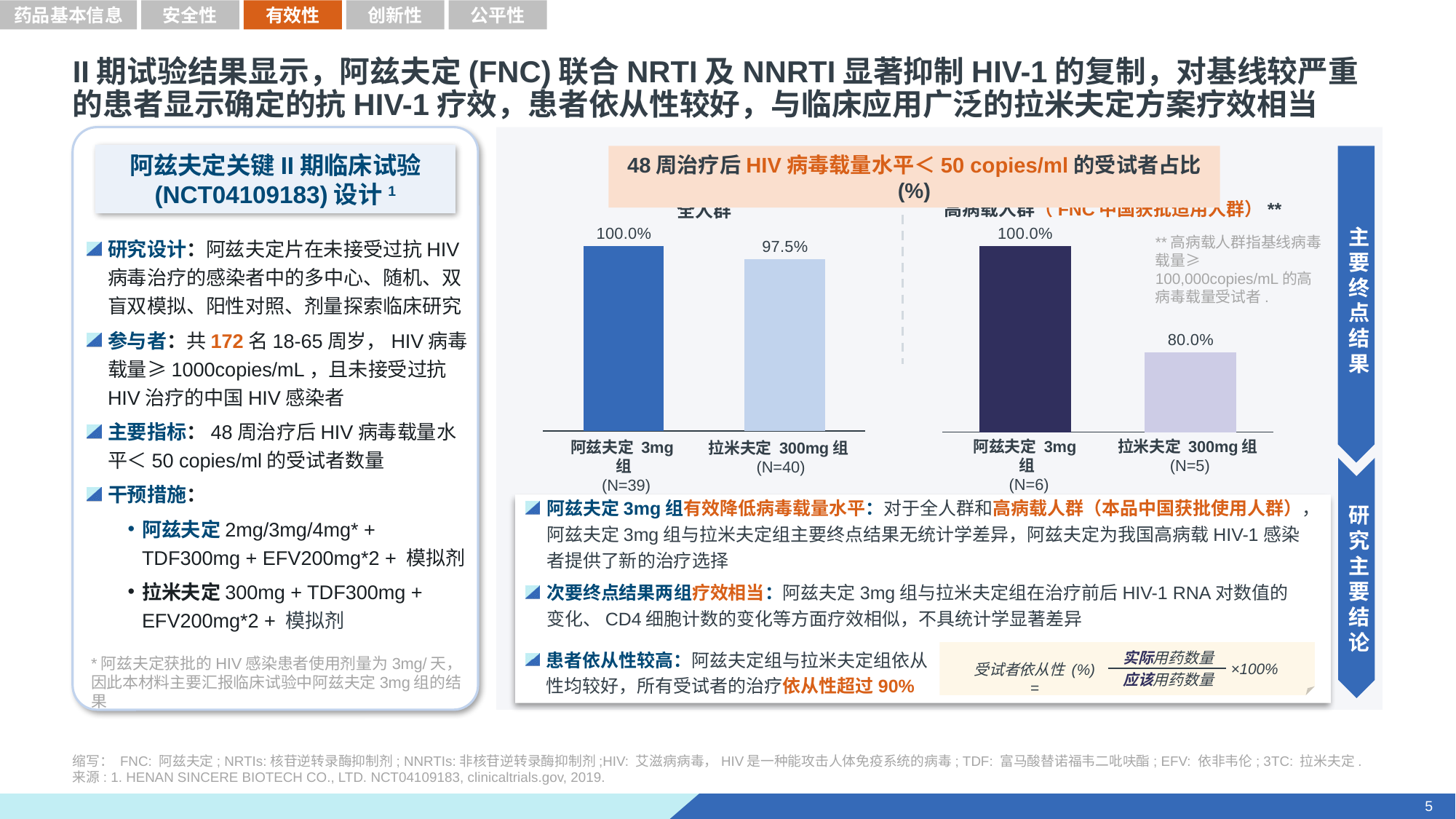
In the 全人群 panel of the chart, what is the value for the 拉米夫定 300mg 组? 97.5% In the 高病载人群 panel of the chart, what is the value for the 阿兹夫定 3mg 组? 100.0% What is the sample size (N) shown for the 阿兹夫定 3mg 组 in the 全人群 panel of the chart? N=39 In the 高病载人群 panel of the chart, what is the value for the 拉米夫定 300mg 组? 80.0% In the 全人群 panel of the chart, what is the difference between the 阿兹夫定 3mg 组 and the 拉米夫定 300mg 组? 2.5% How many bars are plotted in the chart in total across both panels? 4 In the 高病载人群 panel of the chart, what is the difference between the 阿兹夫定 3mg 组 and the 拉米夫定 300mg 组? 20.0% In the chart, is the 拉米夫定 300mg 组 value higher in the 全人群 panel or the 高病载人群 panel? 全人群 What is the title of the chart? 48 周治疗后 HIV 病毒载量水平＜ 50 copies/ml 的受试者占比 (%) What type of chart is shown on the slide? Bar chart In the 高病载人群 panel of the chart, which group has the lower value? 拉米夫定 300mg 组 In the 全人群 panel of the chart, what is the value for the 阿兹夫定 3mg 组? 100.0%